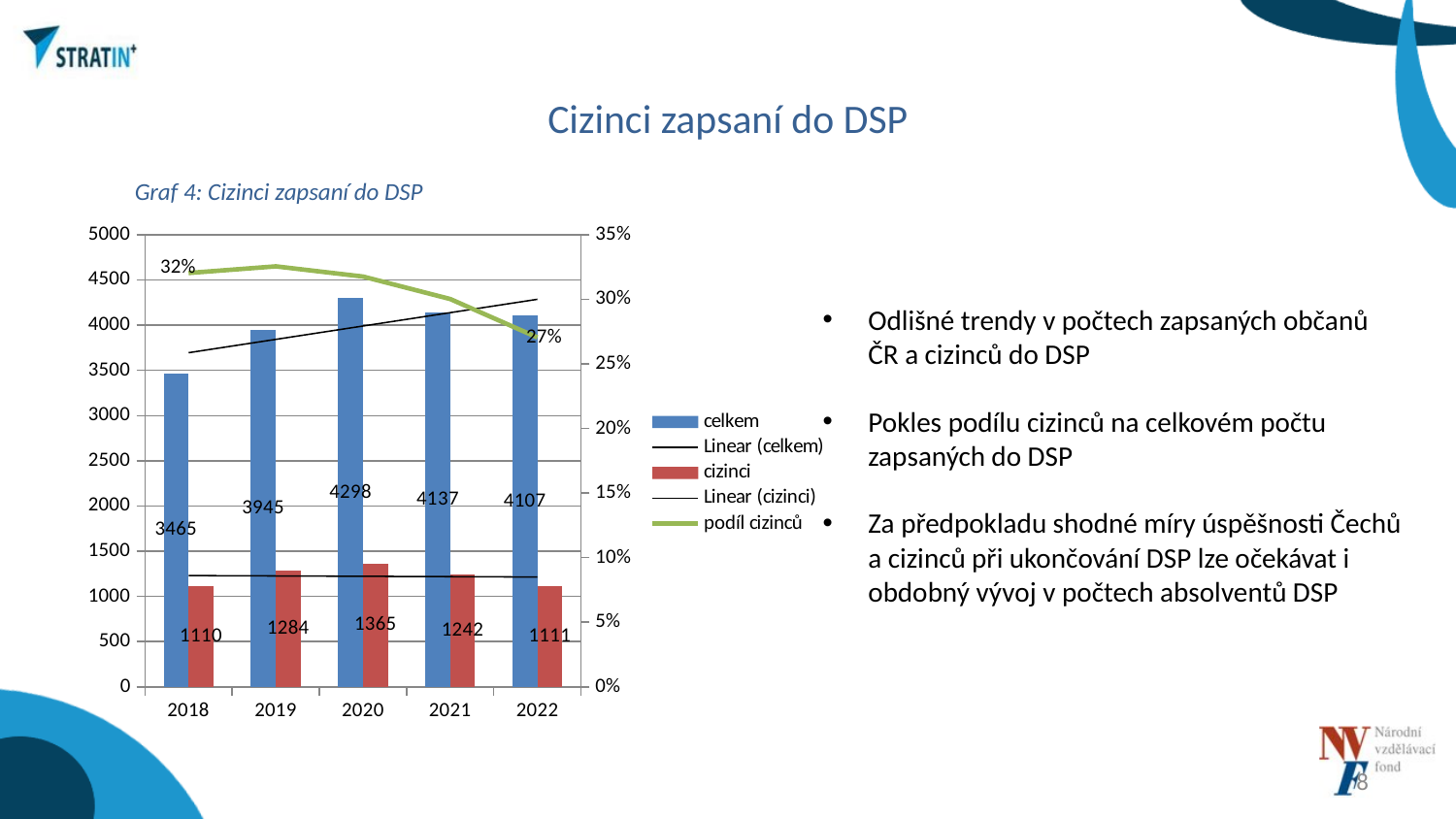
How many years are shown on the x axis? 5 Which year has the highest 'celkem' value? 2020 What is the value of 'cizinci' for 2019? 1284 What is the value of 'celkem' for 2020? 4298 Which year has the lowest 'cizinci' value? 2018 Which is larger, the 'cizinci' value for 2021 or for 2022? 2021 What is the 'podíl cizinců' value shown for 2022? 27% What is the difference between the 'celkem' values for 2020 and 2018? 833 What is the 'podíl cizinců' value shown for 2018? 32% What kind of chart is used for the 'celkem' and 'cizinci' series? bar chart How many entries does the legend list? 5 Does the 'podíl cizinců' line rise or fall from 2018 to 2022? fall